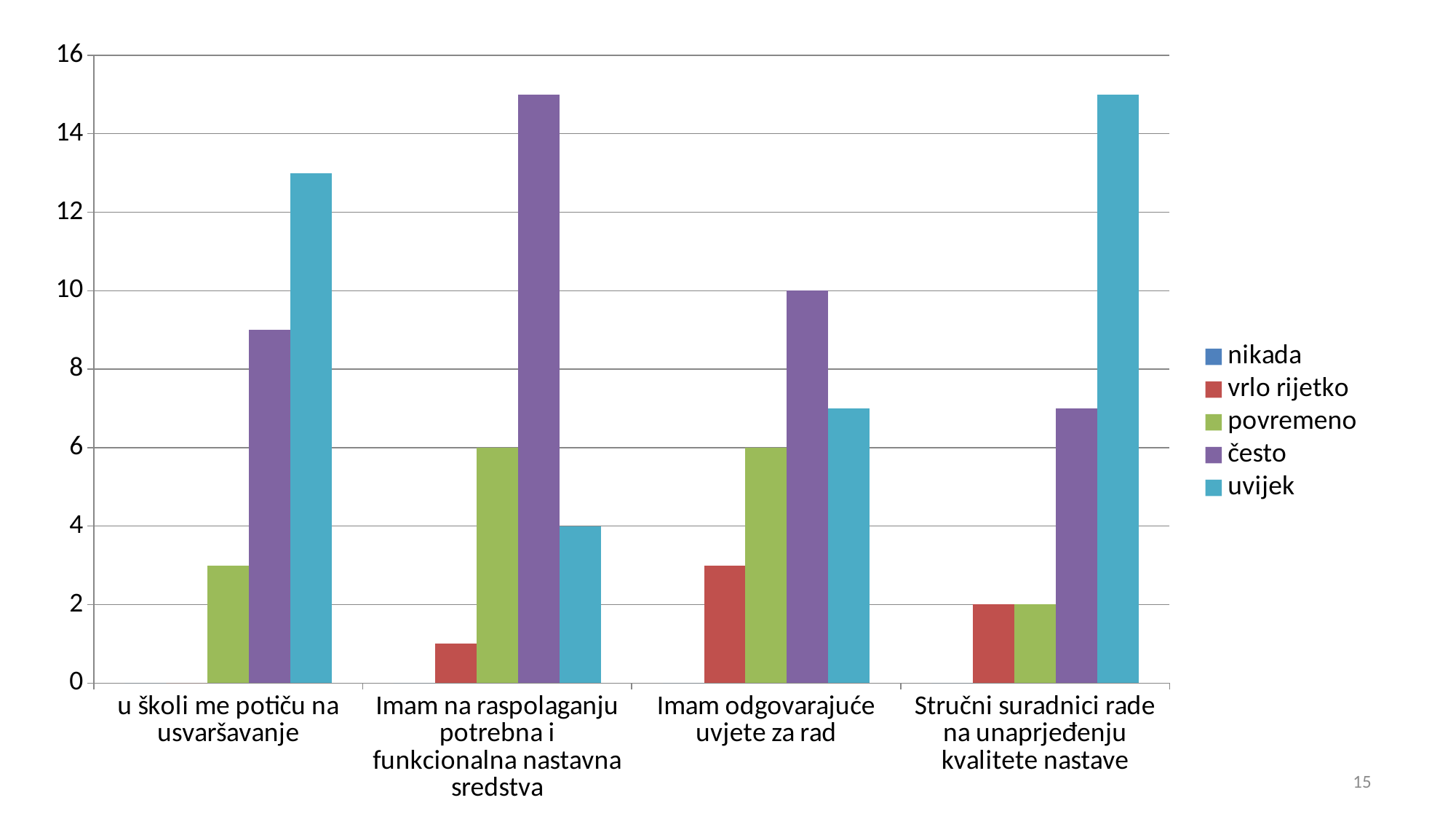
What is the value of "povremeno" for "Imam na raspolaganju potrebna i funkcionalna nastavna sredstva"? 6 How many categories are shown on the x axis? 4 Is the value of "često" for "Imam na raspolaganju potrebna i funkcionalna nastavna sredstva" greater or less than 14? greater What is the value of "često" for "Imam odgovarajuće uvjete za rad"? 10 Which series has the highest value for "Imam odgovarajuće uvjete za rad"? često Is the value of "uvijek" for "u školi me potiču na usvaršavanje" greater or less than 12? greater For "Imam na raspolaganju potrebna i funkcionalna nastavna sredstva", which is larger: "povremeno" or "uvijek"? povremeno Which series has the highest value for "Stručni suradnici rade na unaprjeđenju kvalitete nastave"? uvijek What is the value of "vrlo rijetko" for "Stručni suradnici rade na unaprjeđenju kvalitete nastave"? 2 What kind of chart is shown on the slide? bar chart How many series does the legend list? 5 What is the value of "uvijek" for "Imam na raspolaganju potrebna i funkcionalna nastavna sredstva"? 4